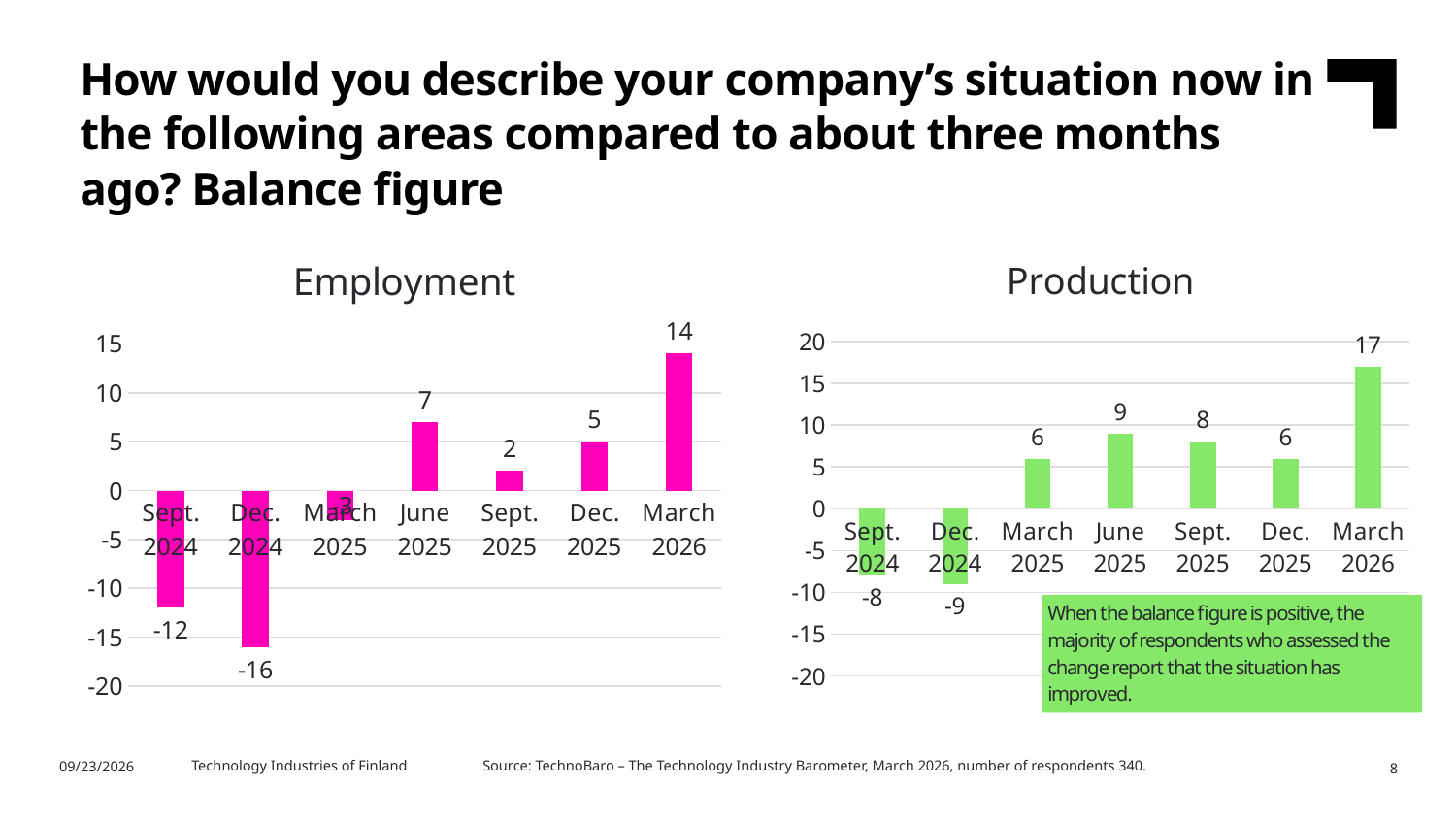
In the Employment chart, what is the balance figure for Dec. 2024? -16 In the Production chart, what is the difference between the balance figures for March 2026 and Dec. 2025? 11 In the Employment chart, what is the balance figure for March 2026? 14 In the Production chart, which period has the highest balance figure? March 2026 In the Employment chart, what is the difference between the balance figures for June 2025 and Sept. 2025? 5 In the Production chart, is the balance figure for March 2026 greater or less than 15? greater In the Production chart, what is the balance figure for Sept. 2024? -8 In the Employment chart, which is larger: the balance figure for Dec. 2025 or for Sept. 2025? Dec. 2025 What kind of chart is the Employment chart? Bar chart In the Employment chart, which period has the lowest balance figure? Dec. 2024 In the Production chart, what is the balance figure for June 2025? 9 How many periods are shown on the x axis of the Production chart? 7